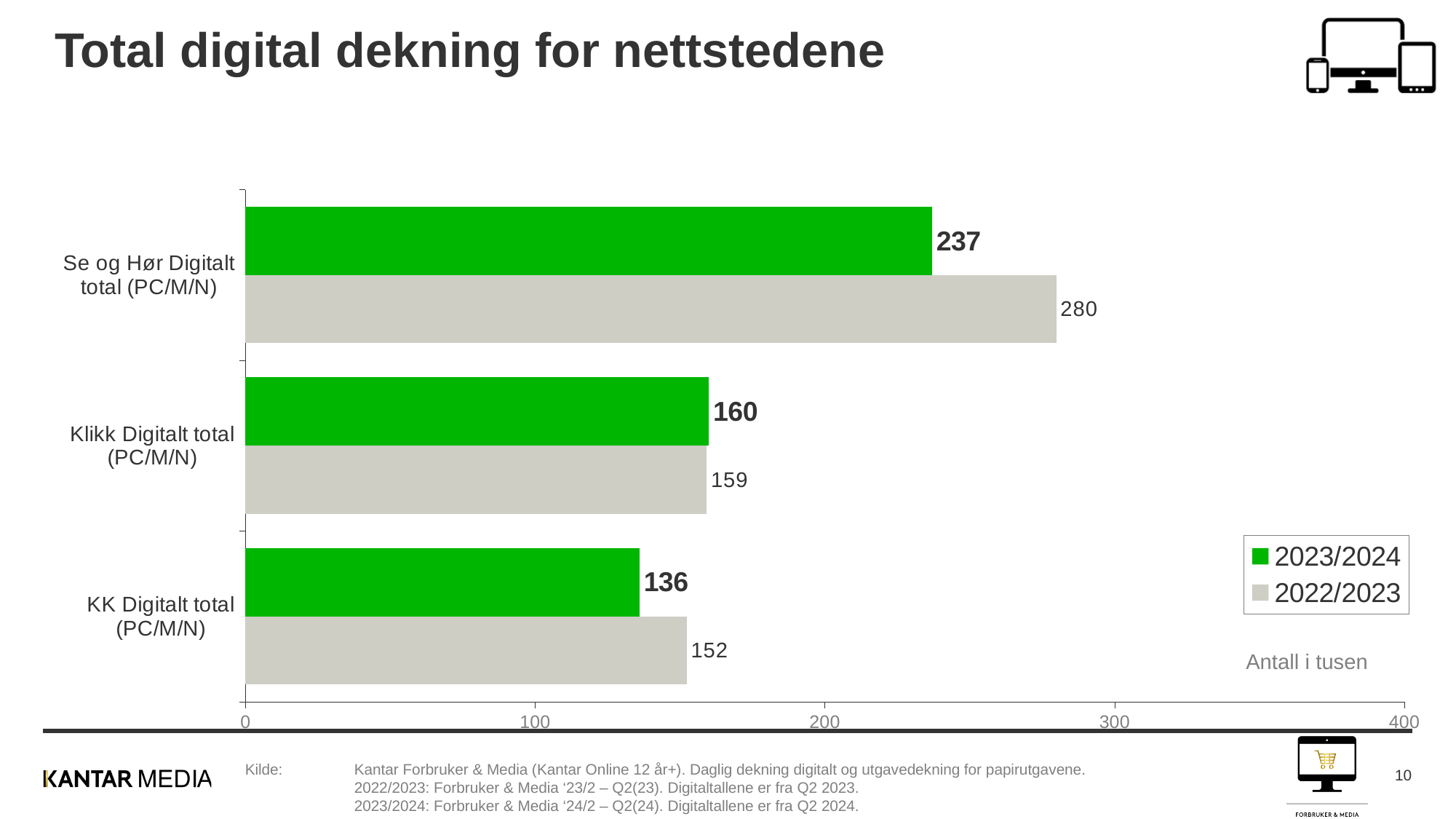
Which category has the highest 2023/2024 value? Se og Hør Digitalt total (PC/M/N) What is the 2022/2023 value for KK Digitalt total (PC/M/N)? 152 Which is larger for Se og Hør Digitalt total (PC/M/N): the 2023/2024 value or the 2022/2023 value? 2022/2023 Is the 2023/2024 value for KK Digitalt total (PC/M/N) greater or less than 200? less How many series does the legend list? 2 What is the difference between the 2022/2023 and 2023/2024 values for KK Digitalt total (PC/M/N)? 16 What is the 2023/2024 value for Se og Hør Digitalt total (PC/M/N)? 237 What is the 2022/2023 value for Klikk Digitalt total (PC/M/N)? 159 Which category has the lowest 2022/2023 value? KK Digitalt total (PC/M/N) What is the difference between the 2022/2023 and 2023/2024 values for Se og Hør Digitalt total (PC/M/N)? 43 How many categories are shown on the chart? 3 What kind of chart is shown on the slide? Bar chart